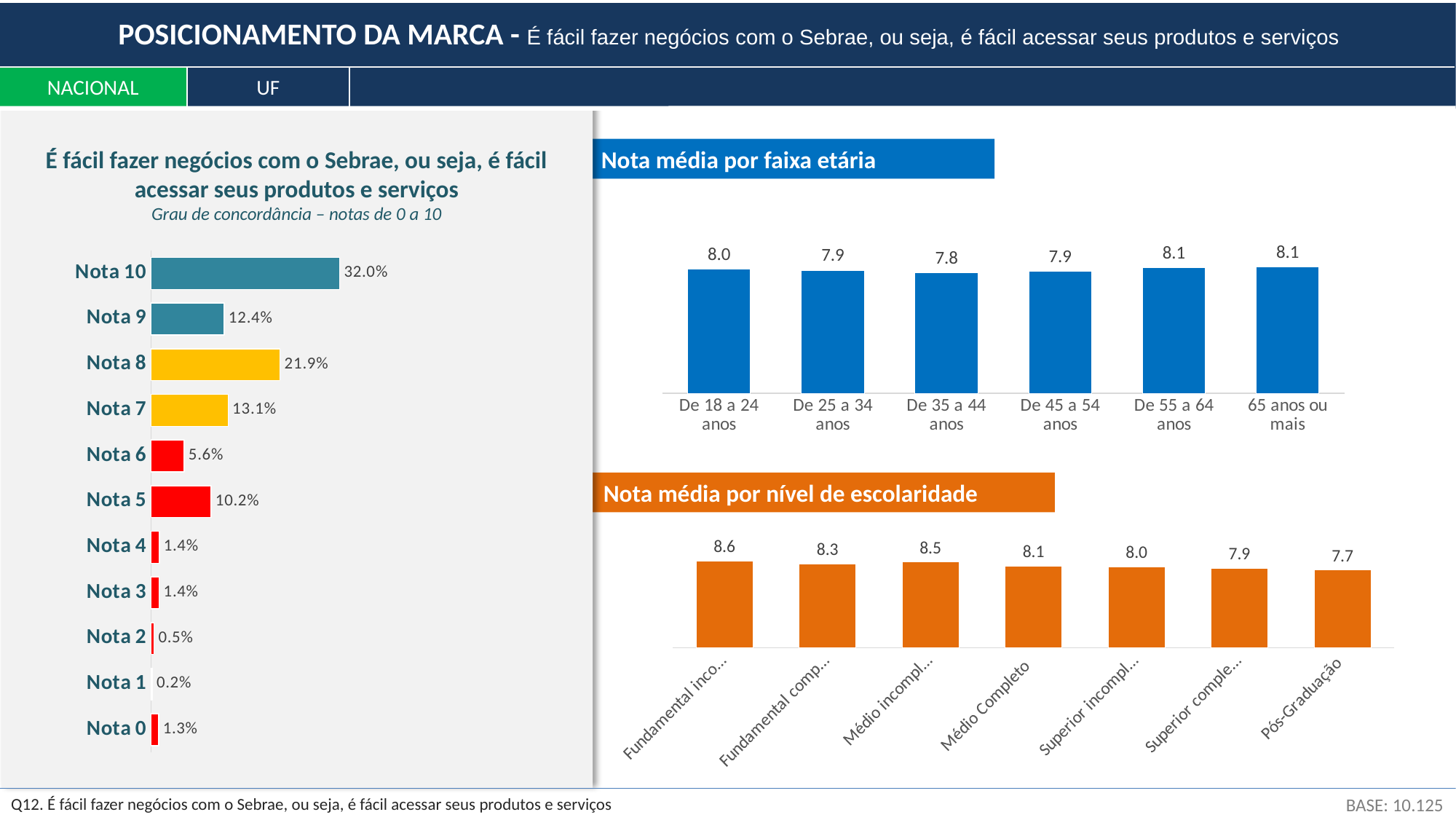
In the chart 'Nota média por faixa etária', which age group has the lowest average score? De 35 a 44 anos In the chart 'Nota média por faixa etária', what is the value for 'De 35 a 44 anos'? 7.8 In the left chart 'É fácil fazer negócios com o Sebrae...', which nota has the lowest percentage? Nota 1 In the chart 'Nota média por nível de escolaridade', which category has the lowest average score? Pós-Graduação In the left chart 'É fácil fazer negócios com o Sebrae...', what is the difference between the percentages for Nota 8 and Nota 7? 8.8% In the chart 'Nota média por faixa etária', how many age groups are shown? 6 In the left chart 'É fácil fazer negócios com o Sebrae...', how many notas (categories) are shown? 11 In the chart 'Nota média por nível de escolaridade', what is the value for 'Médio Completo'? 8.1 In the left chart 'É fácil fazer negócios com o Sebrae...', which nota has the highest percentage? Nota 10 In the left chart 'É fácil fazer negócios com o Sebrae...', what percentage is shown for Nota 10? 32.0% What type of chart is 'Nota média por nível de escolaridade'? Bar chart In the chart 'Nota média por nível de escolaridade', what is the difference between the highest value (8.6) and the value for Pós-Graduação? 0.9